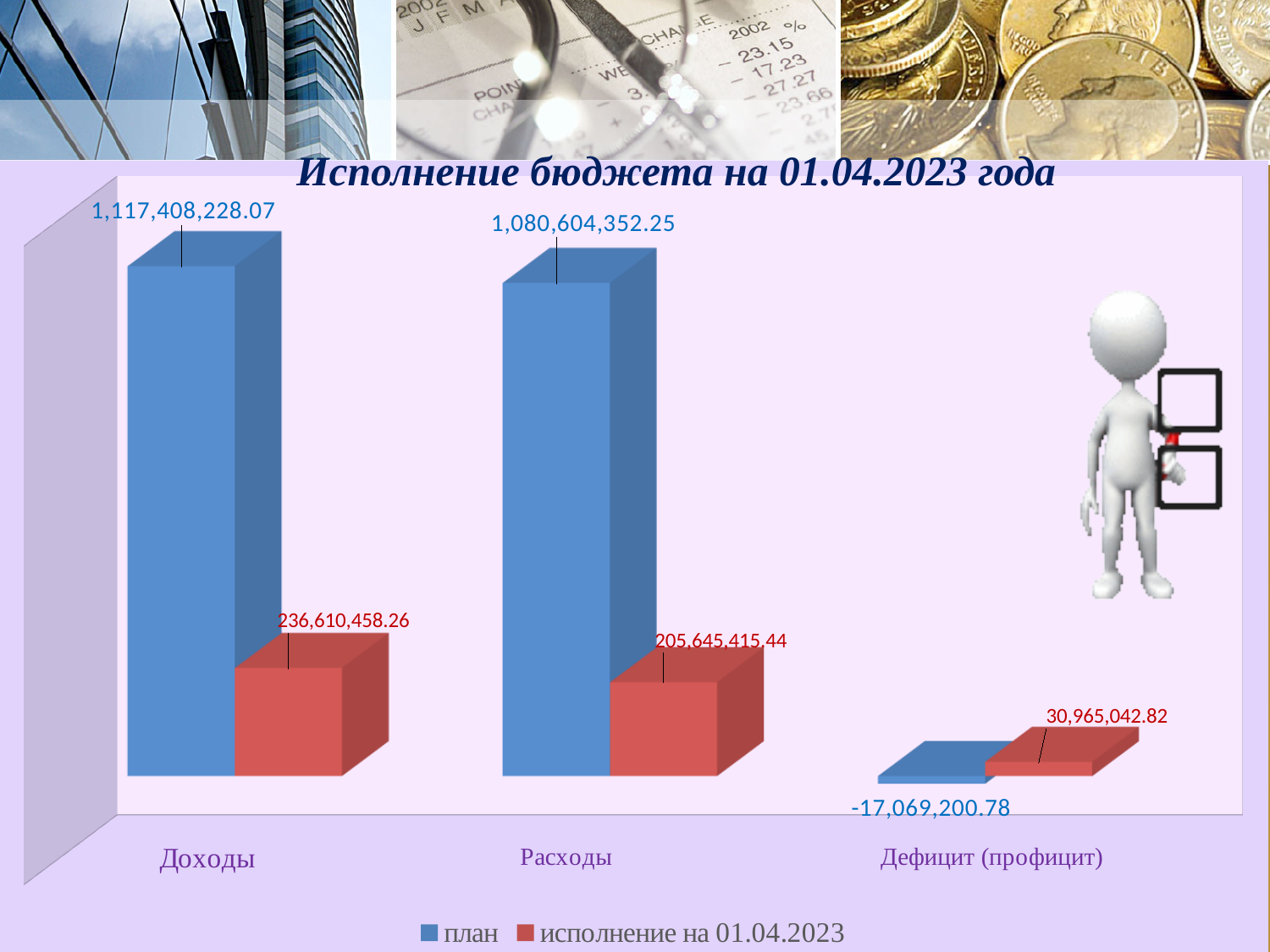
Which category has the highest план value? Доходы What is the difference between the план values for Доходы and Расходы? 36,803,875.82 What is the план value for Дефицит (профицит)? -17,069,200.78 How many categories are shown on the x axis? 3 Which is larger for Расходы: the план value or the исполнение на 01.04.2023 value? план What is the difference between the исполнение на 01.04.2023 values for Доходы and Расходы? 30,965,042.82 What is the план value for Доходы? 1,117,408,228.07 Which category has the lowest исполнение на 01.04.2023 value? Дефицит (профицит) What is the исполнение на 01.04.2023 value for Расходы? 205,645,415.44 What type of chart is shown on the slide? bar chart What is the исполнение на 01.04.2023 value for Доходы? 236,610,458.26 How many series does the legend list? 2